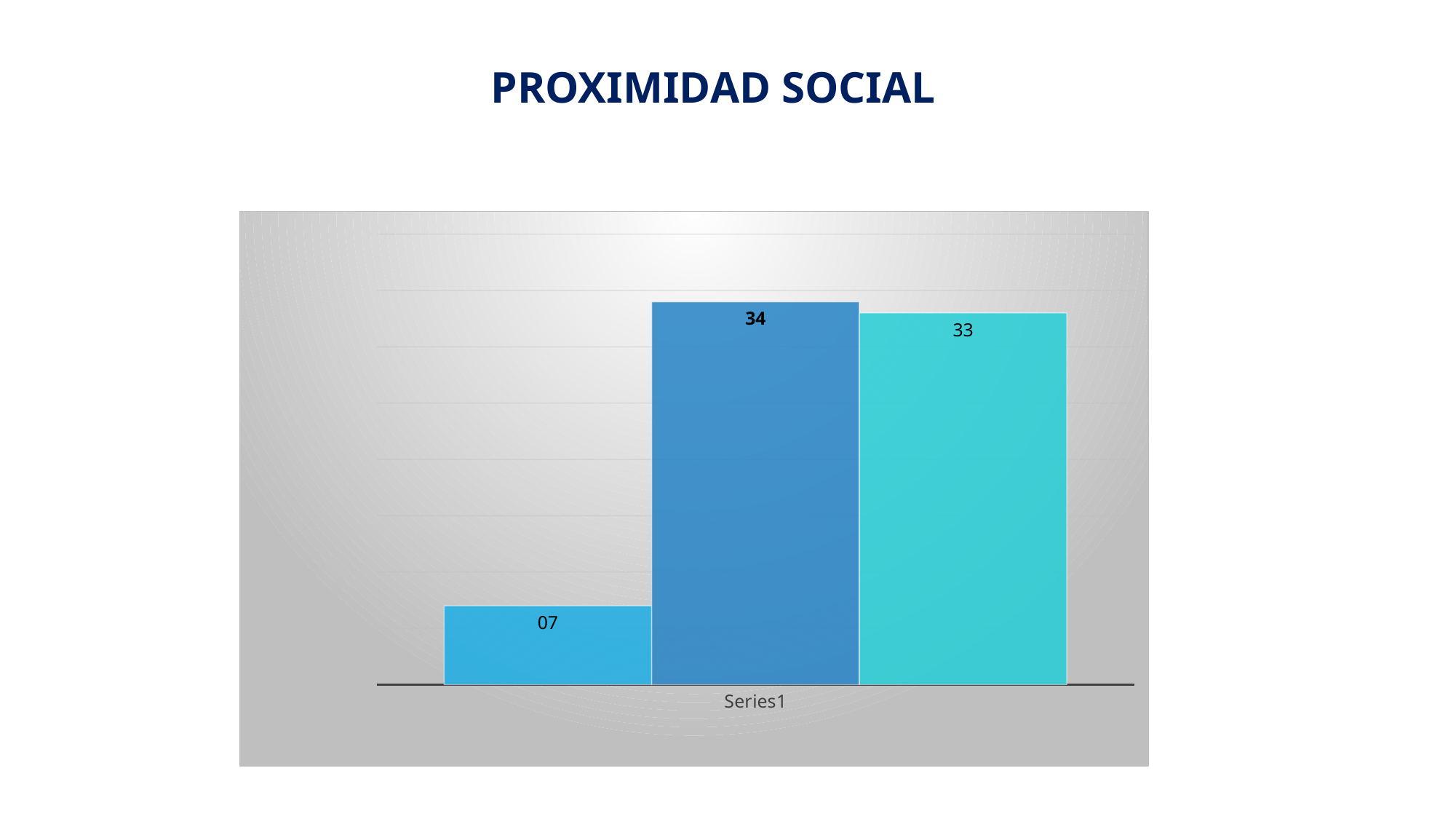
What is the value shown on the middle (dark blue) bar? 34 What is the difference between the middle bar's value and the rightmost bar's value? 1 What is the value shown on the leftmost bar? 07 What is the value shown on the rightmost (turquoise) bar? 33 What is the title of the slide? PROXIMIDAD SOCIAL Which is larger, the value of the leftmost bar or the value of the rightmost bar? the rightmost bar (33) Which bar has the highest value? the middle bar (34) What is the difference between the middle bar's value and the leftmost bar's value? 27 What category label appears on the x axis below the bars? Series1 What kind of chart is shown on the slide? bar chart How many bars are plotted in the chart? 3 Which bar has the lowest value? the leftmost bar (07)